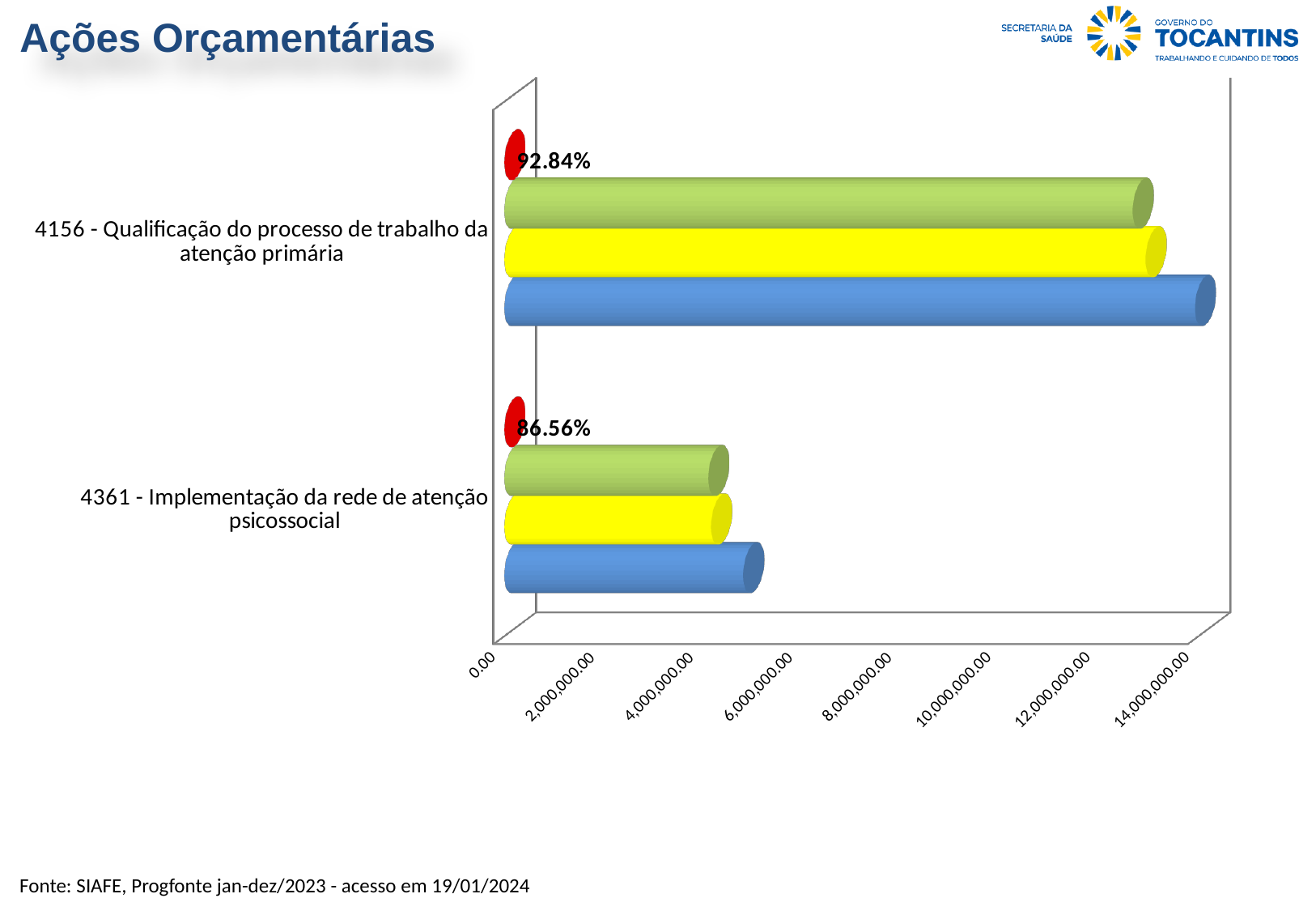
What source is cited below the chart? Fonte: SIAFE, Progfonte jan-dez/2023 - acesso em 19/01/2024 How many categories (budget actions) are shown on the chart? 2 What kind of chart is shown on the slide? Bar chart What is the title of the chart on the slide? Ações Orçamentárias Which category has the lower percentage label? 4361 - Implementação da rede de atenção psicossocial Which category has the higher percentage label? 4156 - Qualificação do processo de trabalho da atenção primária What is the difference between the percentage labels of the two categories? 6.28 percentage points Is the blue bar for '4361 - Implementação da rede de atenção psicossocial' greater or less than 6,000,000.00? less Is the blue bar for '4156 - Qualificação do processo de trabalho da atenção primária' greater or less than 12,000,000.00? greater What percentage label is shown for '4361 - Implementação da rede de atenção psicossocial'? 86.56% Which category has the longer blue bar, 4156 or 4361? 4156 - Qualificação do processo de trabalho da atenção primária What percentage label is shown for '4156 - Qualificação do processo de trabalho da atenção primária'? 92.84%